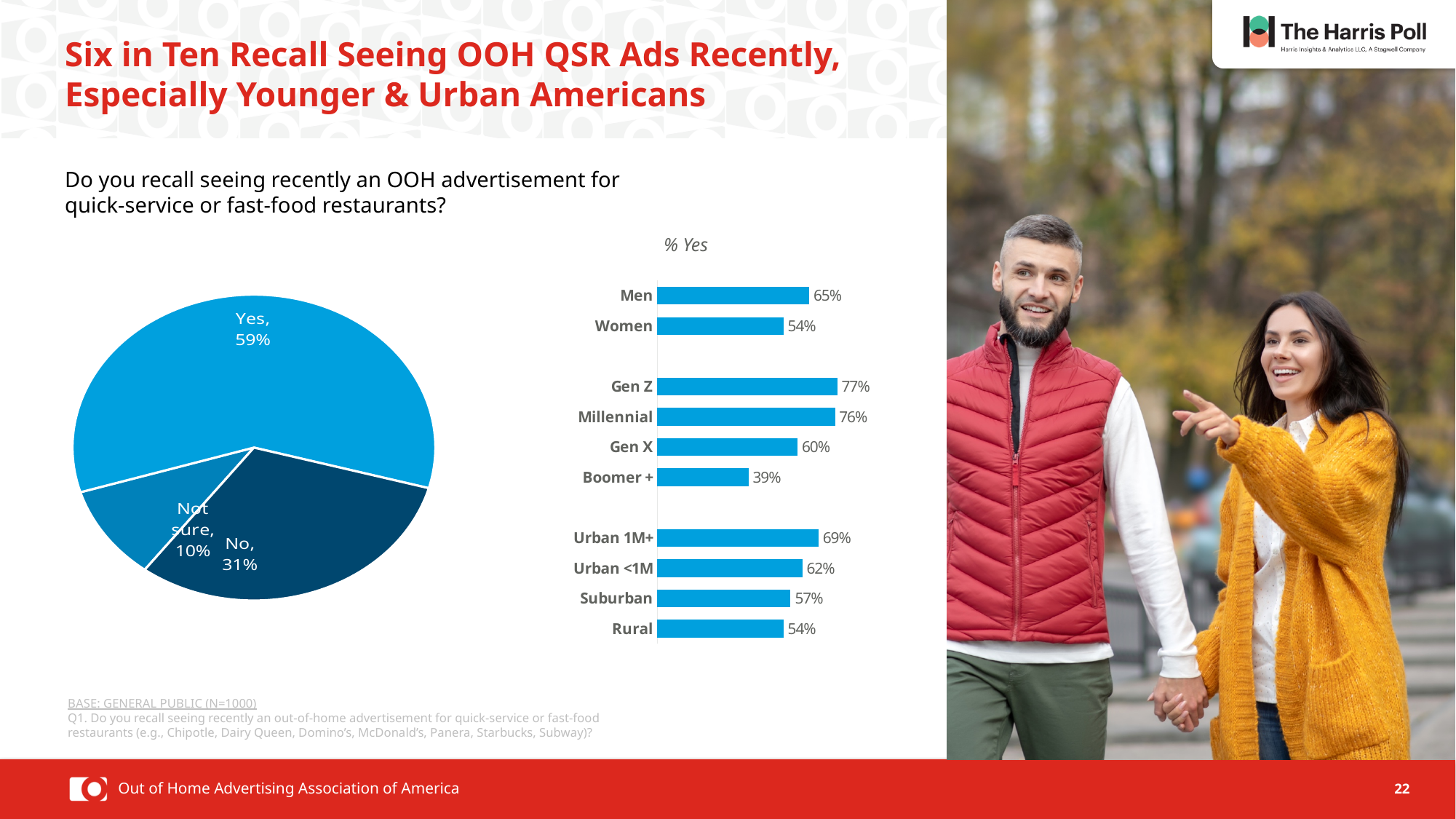
In the '% Yes' bar chart, which category has the highest value? Gen Z In the pie chart, what share of respondents answered Yes? 59% In the pie chart, what share of respondents answered No? 31% How many slices does the pie chart have? 3 In the pie chart, what share of respondents answered Not sure? 10% In the '% Yes' bar chart, which is larger, Urban 1M+ or Suburban? Urban 1M+ What kind of chart is the '% Yes' chart? bar chart In the '% Yes' bar chart, which category has the lowest value? Boomer + In the '% Yes' bar chart, what is the difference between Men and Women? 11% In the '% Yes' bar chart, what is the value for Gen Z? 77% In the '% Yes' bar chart, what is the value for Boomer +? 39% What kind of chart is the chart on the left of the slide? pie chart